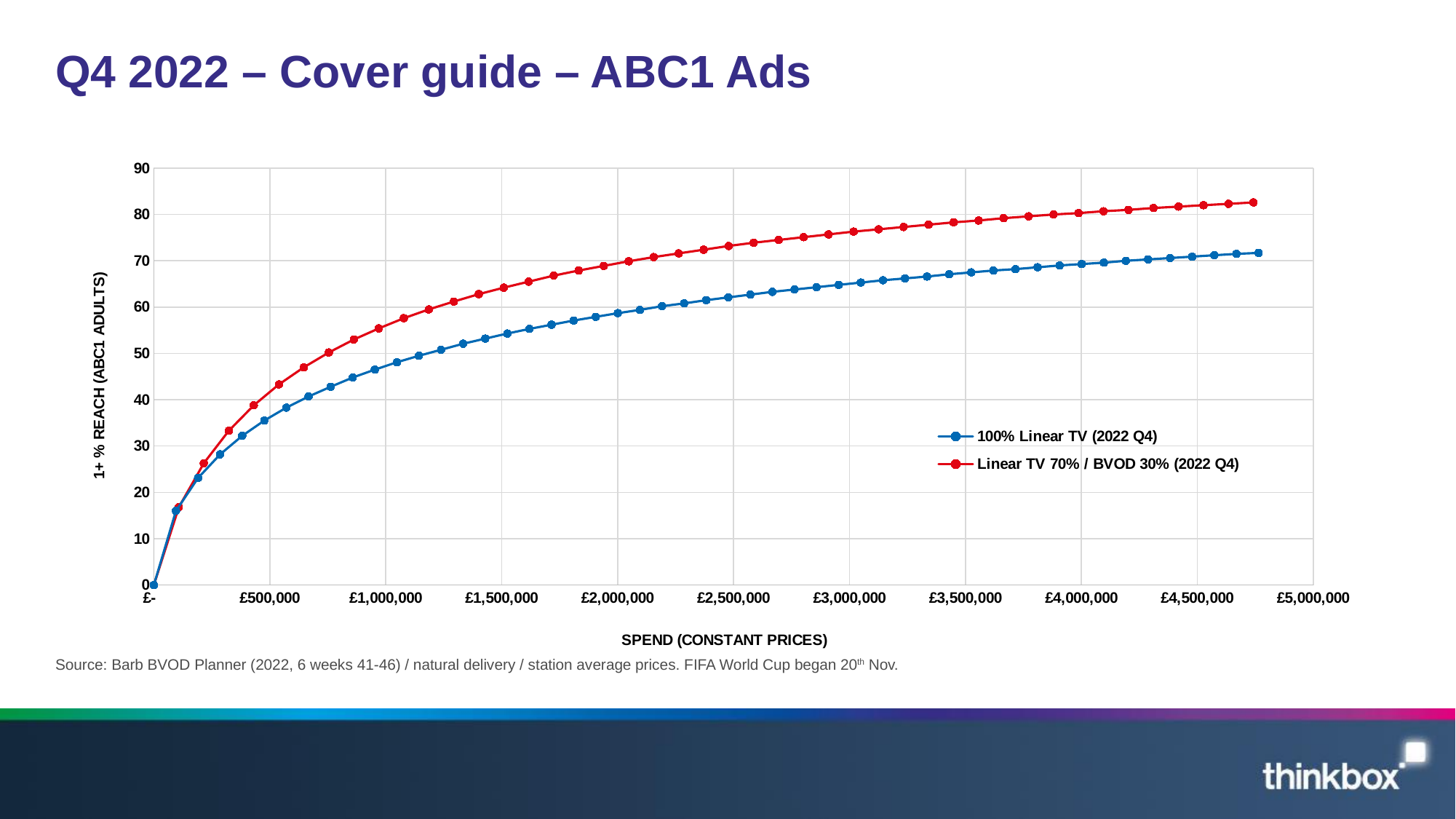
Do the values for 100% Linear TV (2022 Q4) rise or fall as spend increases? Rise At a spend of £2,500,000, which series has the higher reach: 100% Linear TV (2022 Q4) or Linear TV 70% / BVOD 30% (2022 Q4)? Linear TV 70% / BVOD 30% (2022 Q4) Is the value for 100% Linear TV (2022 Q4) at £4,500,000 spend greater or less than 80? less Is the value for Linear TV 70% / BVOD 30% (2022 Q4) at £3,000,000 spend greater or less than 70? greater How many series does the legend list? 2 What is the title of the y axis? 1+ % REACH (ABC1 ADULTS) What kind of chart is shown on the slide? Line chart Which series is plotted in red? Linear TV 70% / BVOD 30% (2022 Q4) Is the value for Linear TV 70% / BVOD 30% (2022 Q4) at £4,500,000 spend greater or less than 80? greater What is the title of the x axis? SPEND (CONSTANT PRICES)